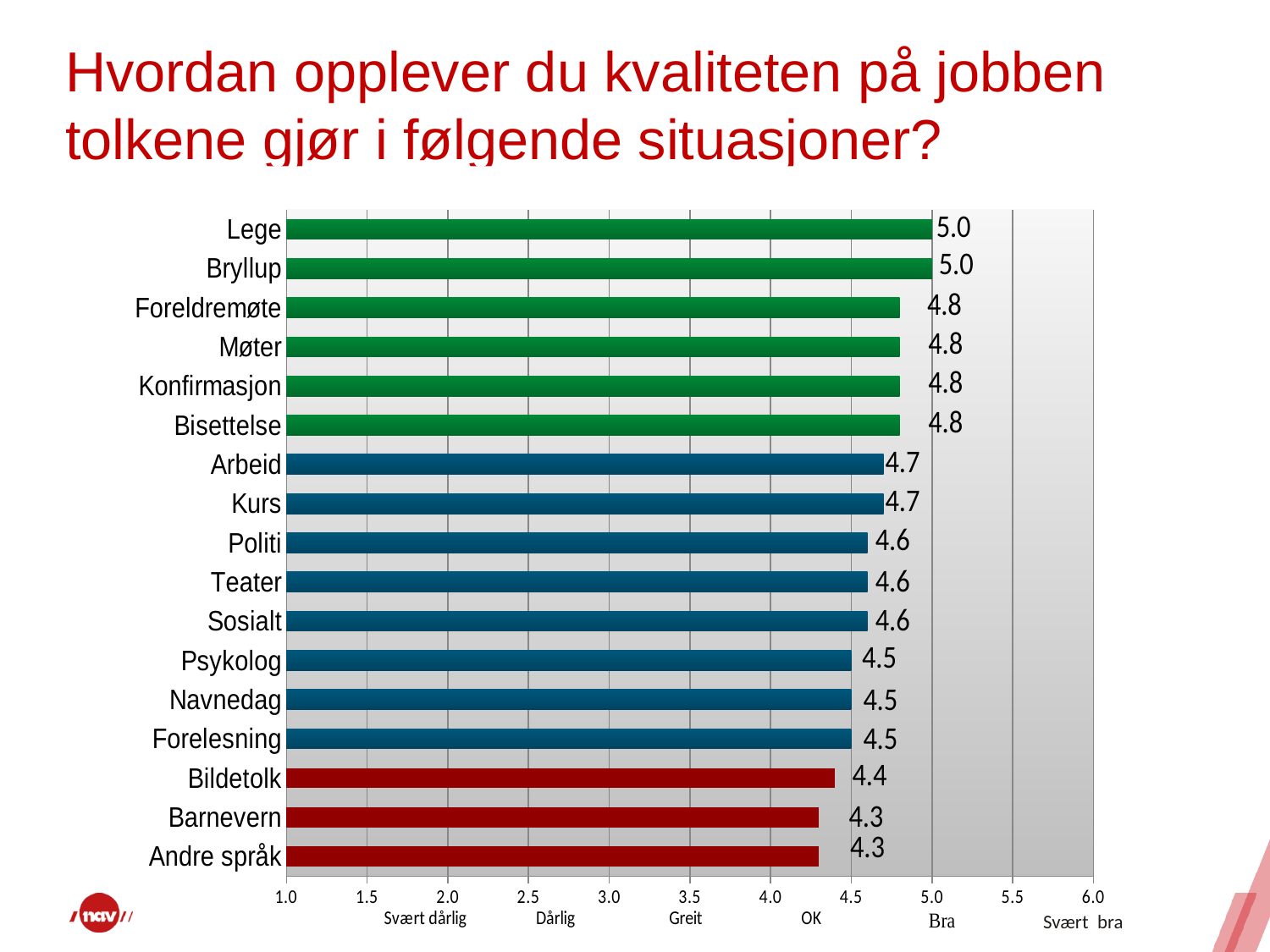
Is the value for Barnevern greater or less than 4.5? less What is the difference between the value for Lege and the value for Andre språk? 0.7 Which two categories share the highest value on the chart? Lege and Bryllup What kind of chart is shown on the slide? bar chart What is the value for Lege? 5.0 Which has a larger value, Arbeid or Politi? Arbeid What is the value for Psykolog? 4.5 How many categories are shown on the chart? 17 What is the value for Politi? 4.6 What is the difference between the value for Foreldremøte and the value for Bildetolk? 0.4 Which two categories share the lowest value on the chart? Barnevern and Andre språk What is the value for Bildetolk? 4.4